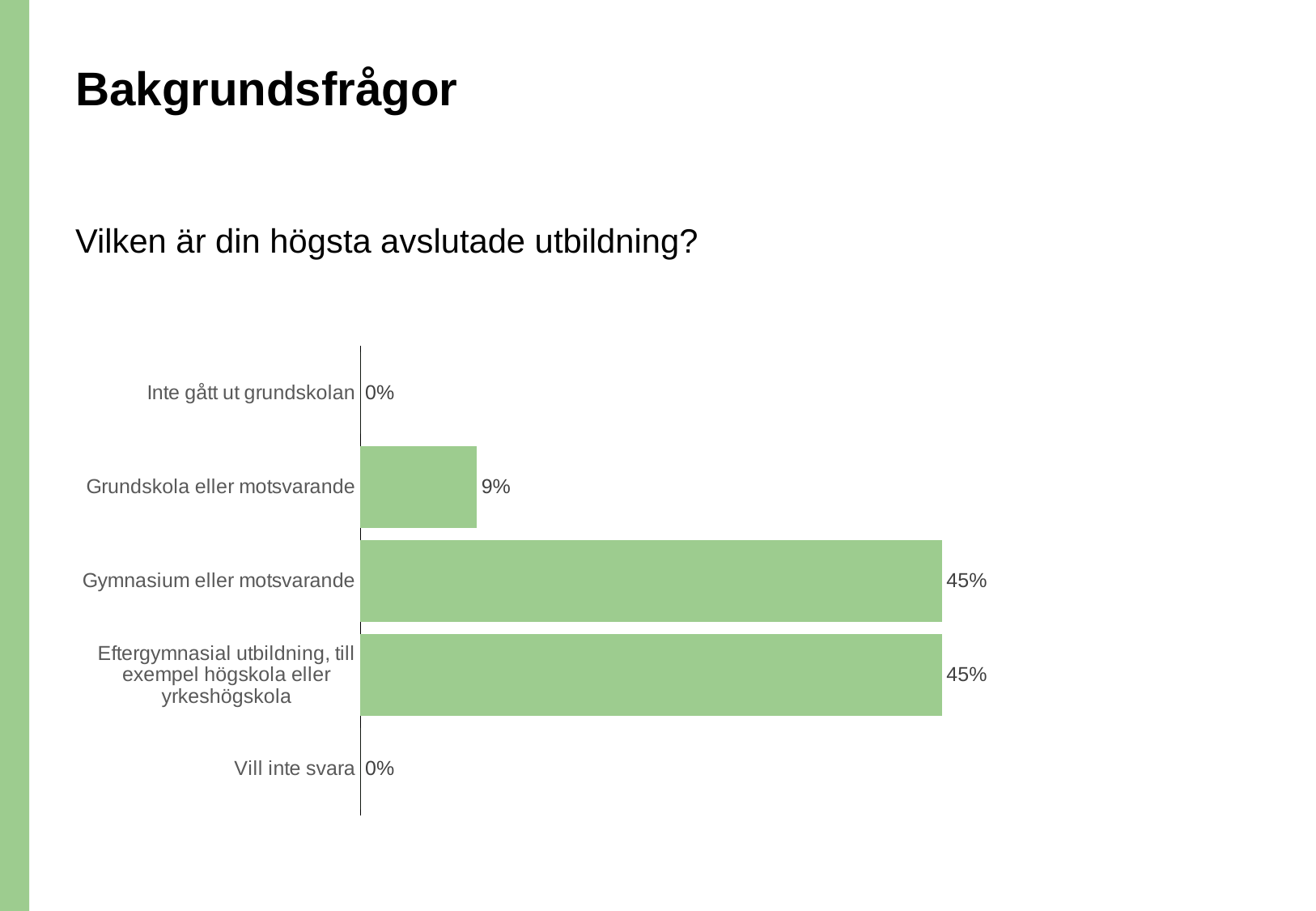
What is the difference between the values for Gymnasium eller motsvarande and Grundskola eller motsvarande? 36% What is the value for Eftergymnasial utbildning, till exempel högskola eller yrkeshögskola? 45% What is the value for Gymnasium eller motsvarande? 45% What is the value for Grundskola eller motsvarande? 9% What is the value for Vill inte svara? 0% What is the total of the values for Grundskola eller motsvarande and Gymnasium eller motsvarande? 54% What question does the chart on the slide answer? Vilken är din högsta avslutade utbildning? How many categories does the chart show? 5 What colour are the bars in the chart? Green What is the value for Inte gått ut grundskolan? 0% Which is larger, the value for Grundskola eller motsvarande or the value for Gymnasium eller motsvarande? Gymnasium eller motsvarande What kind of chart is shown on the slide? Bar chart